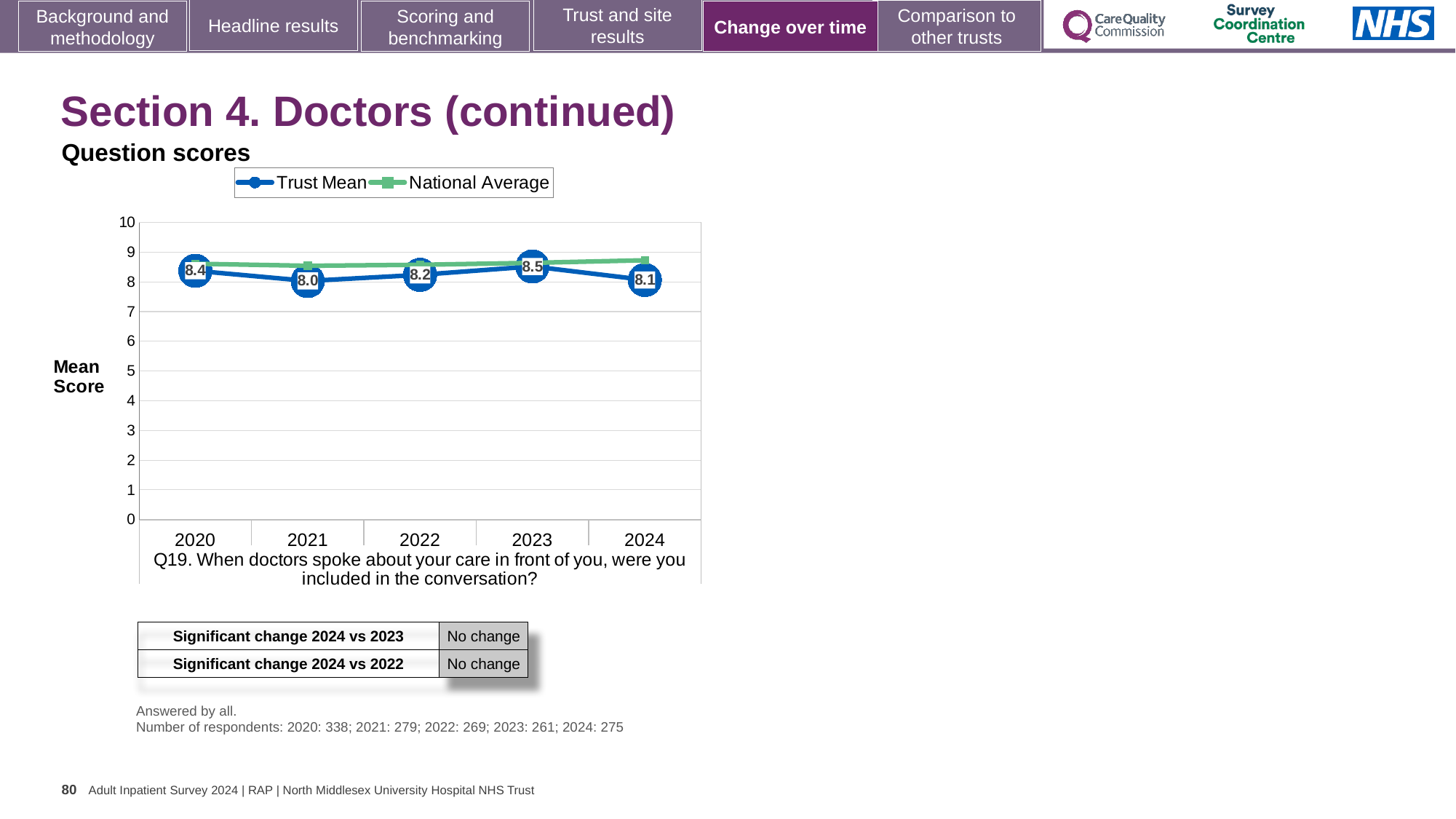
What is the Trust Mean score for 2023? 8.5 Which is larger, the Trust Mean score for 2020 or for 2022? 2020 Does the Trust Mean score rise or fall from 2023 to 2024? Fall What kind of chart is shown on the slide? Line chart What is the Trust Mean score for 2021? 8.0 What is the difference between the Trust Mean scores for 2023 and 2024? 0.4 What is the Trust Mean score for 2024? 8.1 Is the National Average value for 2024 greater or less than 8? greater How many years are shown on the x axis of the chart? 5 How many series does the chart legend list? 2 In which year is the Trust Mean score highest? 2023 In which year is the Trust Mean score lowest? 2021